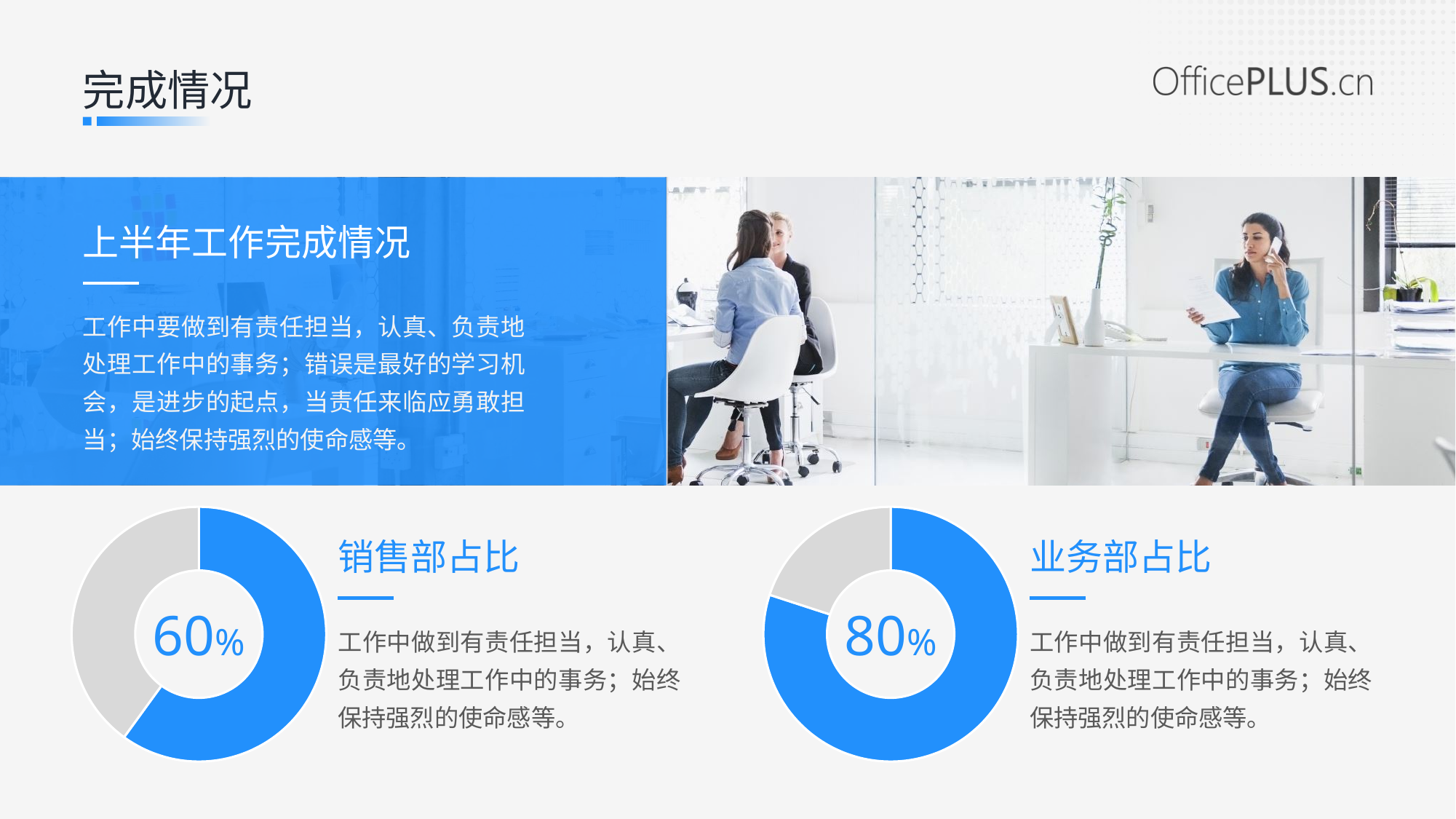
What colour is used for the filled (completed) portion of both donut charts? Blue In the 销售部占比 donut chart, what share of the ring is the grey (remaining) portion? 40% What percentage is shown in the centre of the 业务部占比 donut chart? 80% What is the title next to the donut chart on the right side of the slide? 业务部占比 Is the value shown in the 销售部占比 donut chart greater or less than 50%? greater Which of the two donut charts shows the lower percentage? 销售部占比 What percentage is shown in the centre of the 销售部占比 donut chart? 60% What is the difference in percentage points between the 业务部占比 value and the 销售部占比 value? 20 In the 业务部占比 donut chart, what share of the ring is the grey (remaining) portion? 20% Which department's donut chart shows the higher percentage, 销售部占比 or 业务部占比? 业务部占比 What kind of chart is used to show the 销售部占比 value? Donut chart How many donut charts are shown on the slide? 2